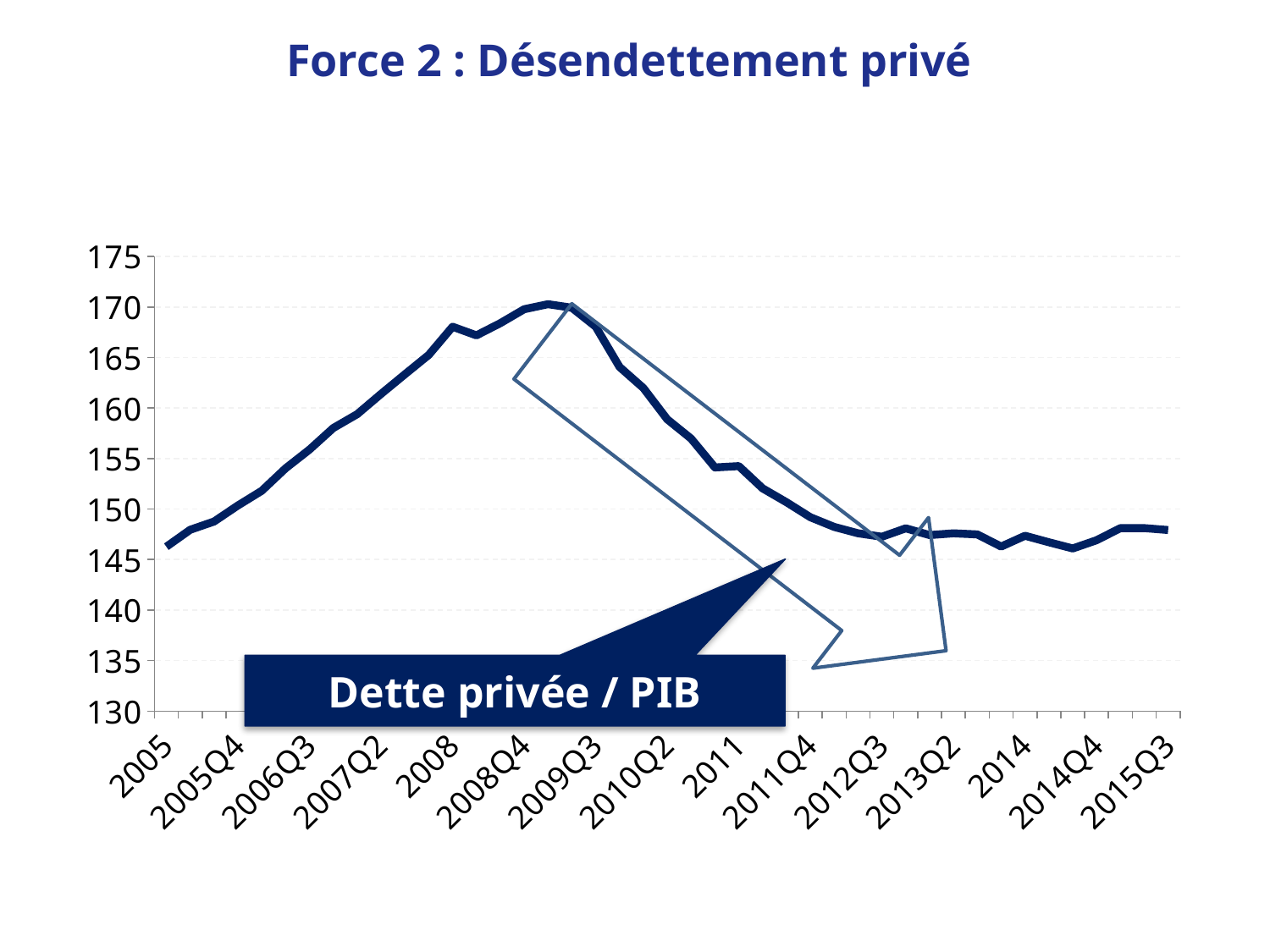
Is the value for 2011 greater or less than 150? greater Is the value for 2010Q2 greater or less than 155? greater Which is larger, the value for 2008 or the value for 2015Q3? 2008 Does the line rise or fall between 2009Q3 and 2011Q4? fall Is the peak value of the line greater or less than 165? greater What label is shown in the box pointing at the line? Dette privée / PIB What kind of chart is shown on the slide? line chart What is the title of the slide? Force 2 : Désendettement privé Does the line rise or fall between 2005 and 2008? rise